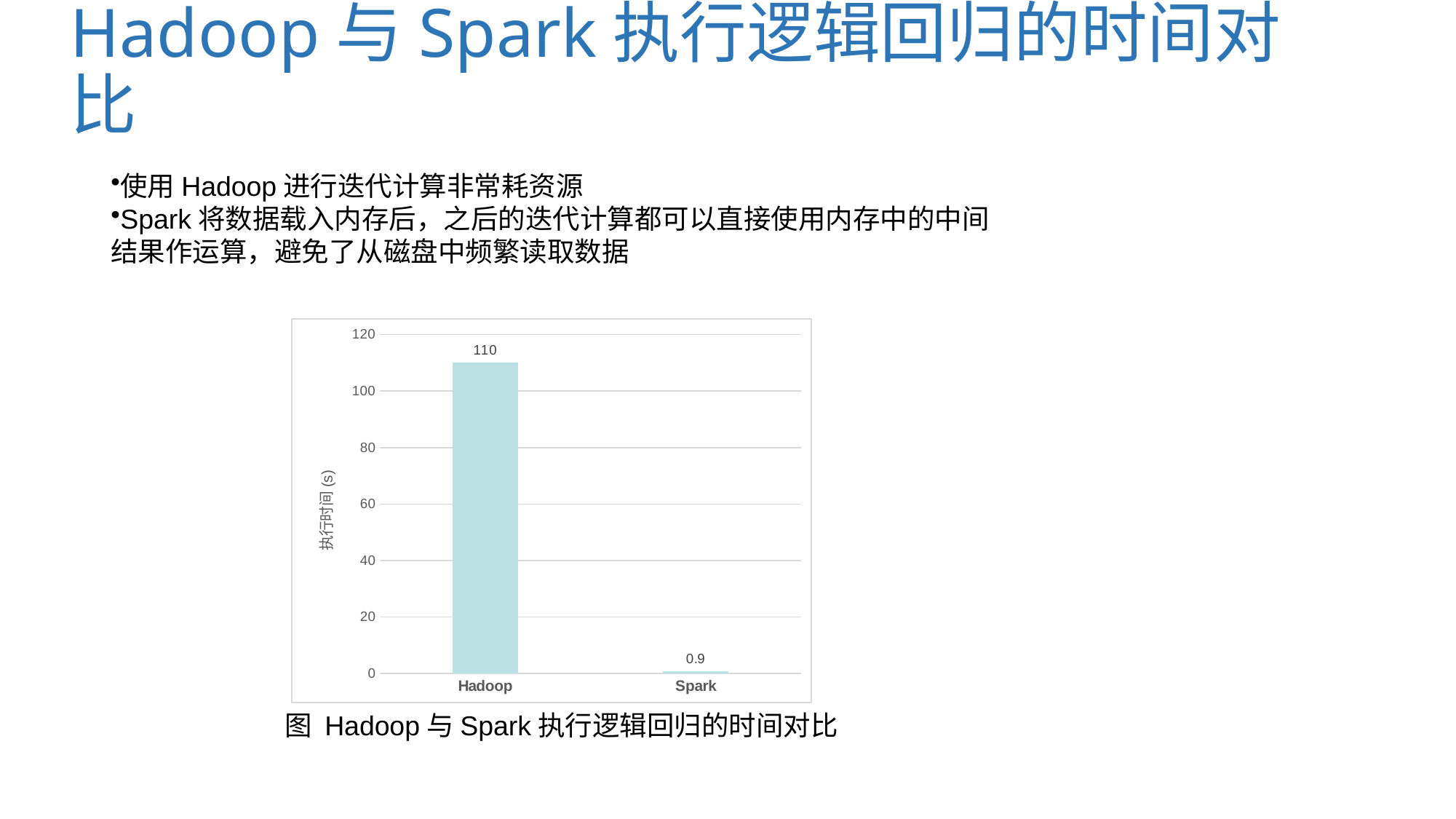
Is the value for Spark greater or less than 20? less What is the execution time shown for Hadoop? 110 What is the execution time shown for Spark? 0.9 Is the value for Hadoop greater or less than 100? greater What is the difference between the Hadoop and Spark execution times? 109.1 How many categories are shown on the x axis? 2 Which category has the highest execution time? Hadoop What is the label of the y axis? 执行时间 (s) What kind of chart is shown on the slide? bar chart Which has a larger execution time, Hadoop or Spark? Hadoop What is the highest value shown on the y axis? 120 Which category has the lowest execution time? Spark